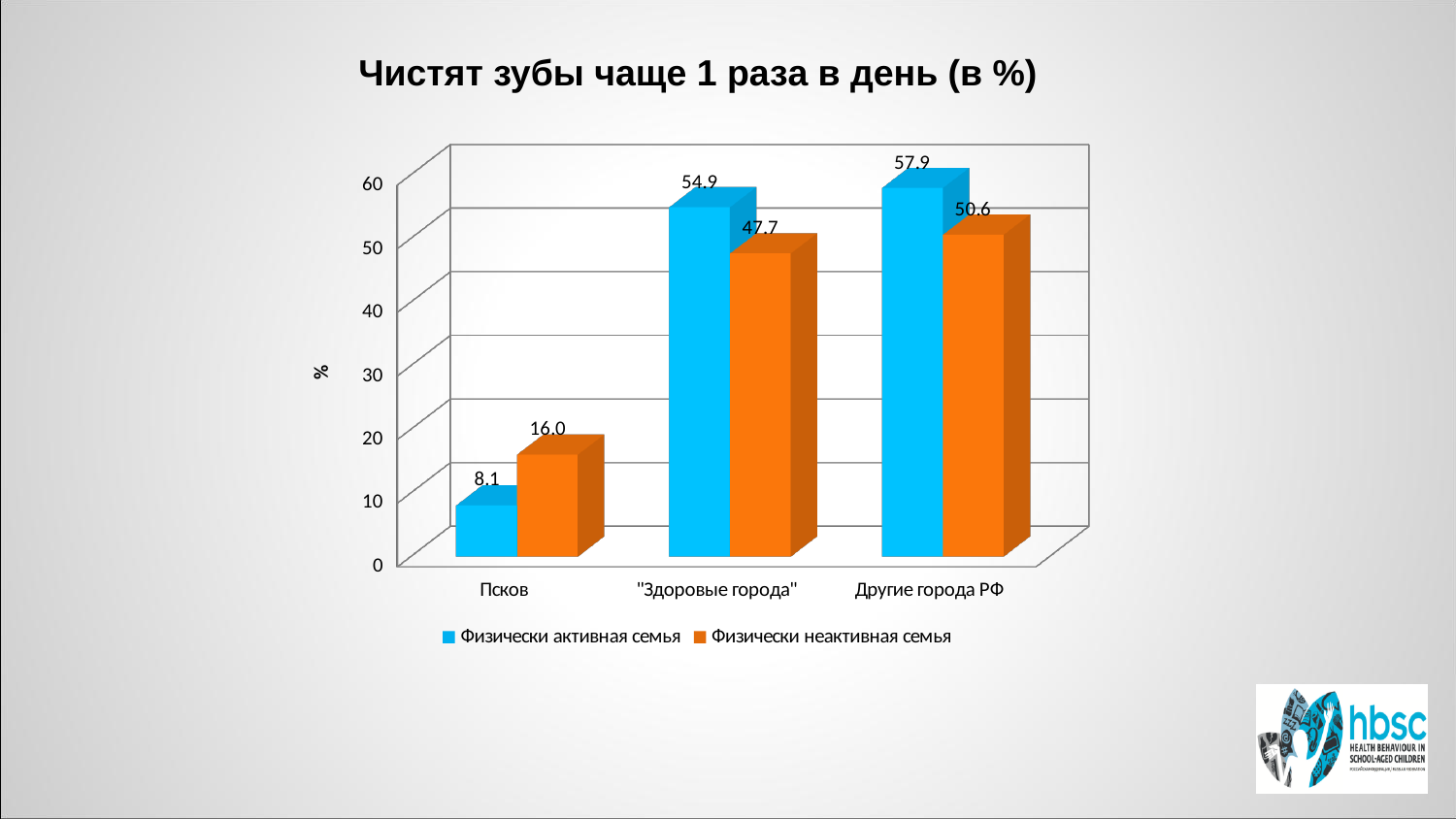
What is the value for Псков in the Физически активная семья series? 8.1 For Псков, which series has the larger value: Физически активная семья or Физически неактивная семья? Физически неактивная семья How many categories are shown on the x axis? 3 What kind of chart is shown on the slide? bar chart Which category has the highest value in the Физически активная семья series? Другие города РФ What is the value for "Здоровые города" in the Физически неактивная семья series? 47.7 How many series does the legend list? 2 What is the value for Другие города РФ in the Физически активная семья series? 57.9 What is the title of the chart? Чистят зубы чаще 1 раза в день (в %) Is the value for "Здоровые города" in the Физически активная семья series greater or less than 50? greater What is the difference between the Физически активная семья and Физически неактивная семья values for Другие города РФ? 7.3 Which category has the lowest value in the Физически неактивная семья series? Псков